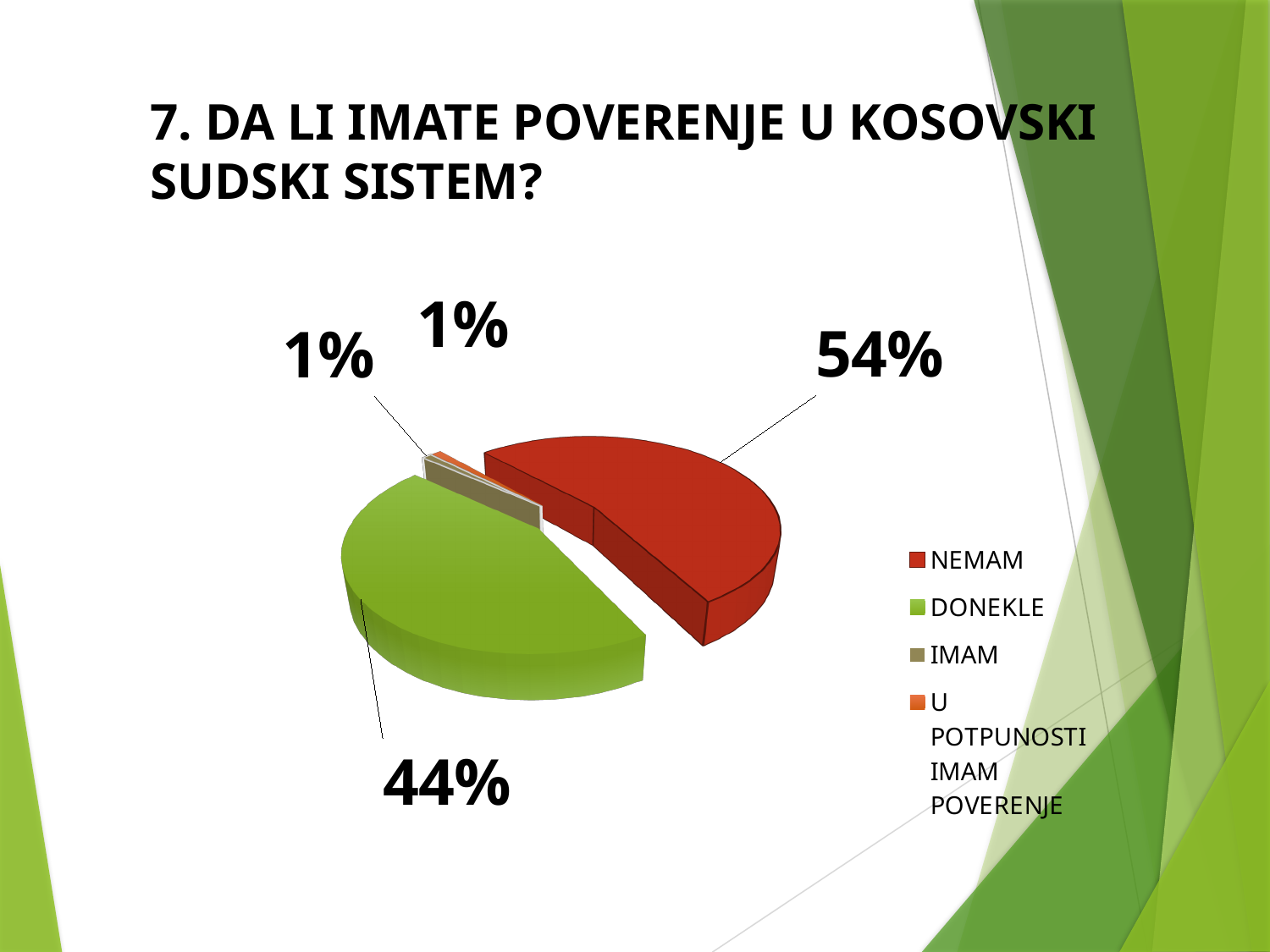
What is the difference in percentage points between NEMAM and DONEKLE? 10 How many categories does the legend list? 4 What is the title of the slide containing the chart? 7. DA LI IMATE POVERENJE U KOSOVSKI SUDSKI SISTEM? What percentage of respondents answered U POTPUNOSTI IMAM POVERENJE? 1% What percentage of respondents answered NEMAM? 54% What kind of chart is shown on the slide? Pie chart What percentage of respondents answered IMAM? 1% Which category has the largest share of the pie? NEMAM What is the combined share of IMAM and U POTPUNOSTI IMAM POVERENJE? 2% What colour is the slice for DONEKLE? Green Which is larger, the share for NEMAM or the share for DONEKLE? NEMAM What percentage of respondents answered DONEKLE? 44%